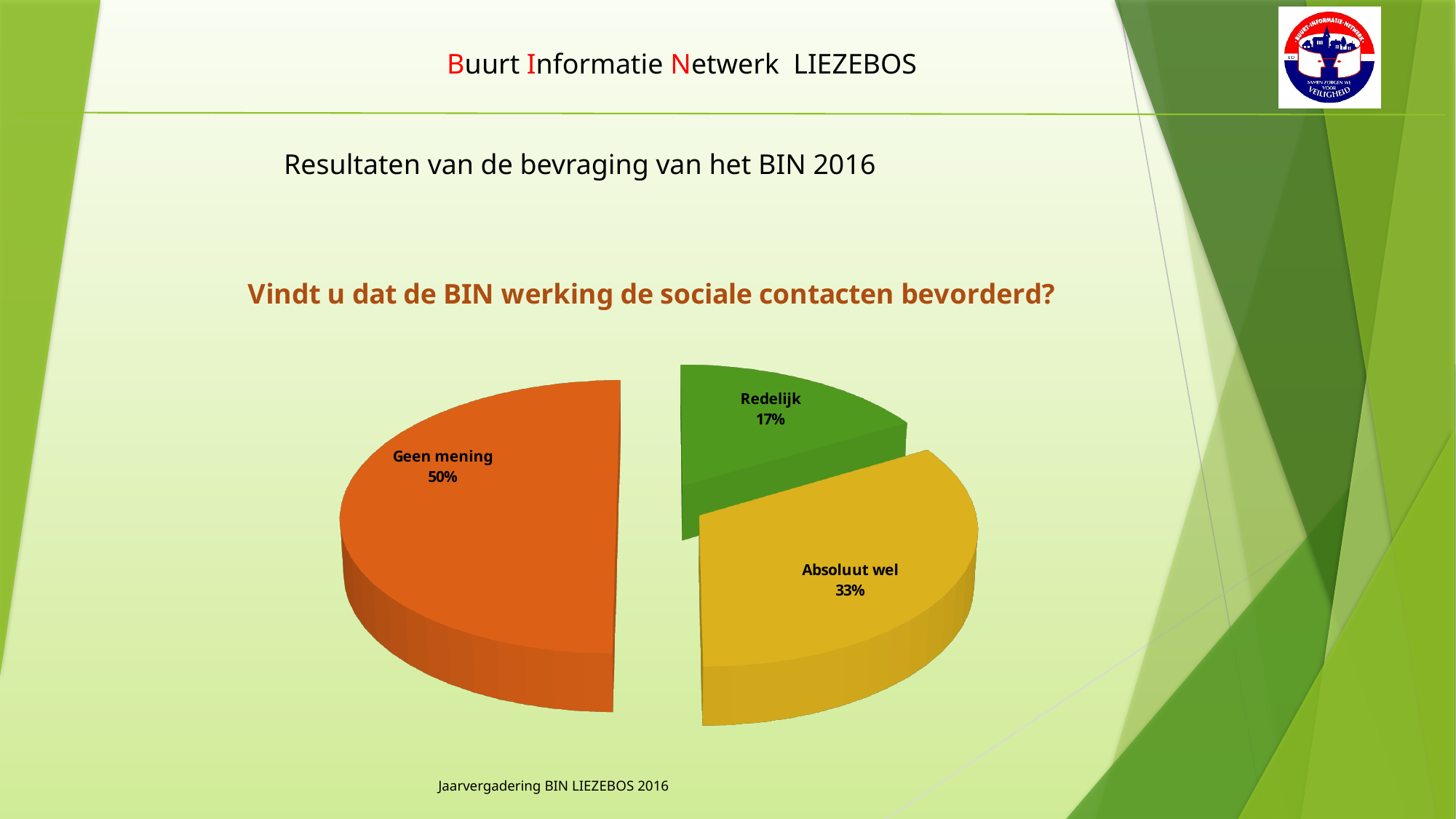
What is the title of the chart? Vindt u dat de BIN werking de sociale contacten bevorderd? Which category has the smallest slice of the pie? Redelijk Which category has the largest slice of the pie? Geen mening What share of the pie does "Redelijk" represent? 17% What kind of chart is shown on the slide? Pie chart Which is larger, the share for "Absoluut wel" or the share for "Redelijk"? Absoluut wel What is the difference in percentage points between "Absoluut wel" and "Redelijk"? 16 What is the difference in percentage points between "Geen mening" and "Absoluut wel"? 17 How many categories are shown in the pie chart? 3 What colour is the "Absoluut wel" slice? Yellow What share of the pie does "Geen mening" represent? 50% What share of the pie does "Absoluut wel" represent? 33%